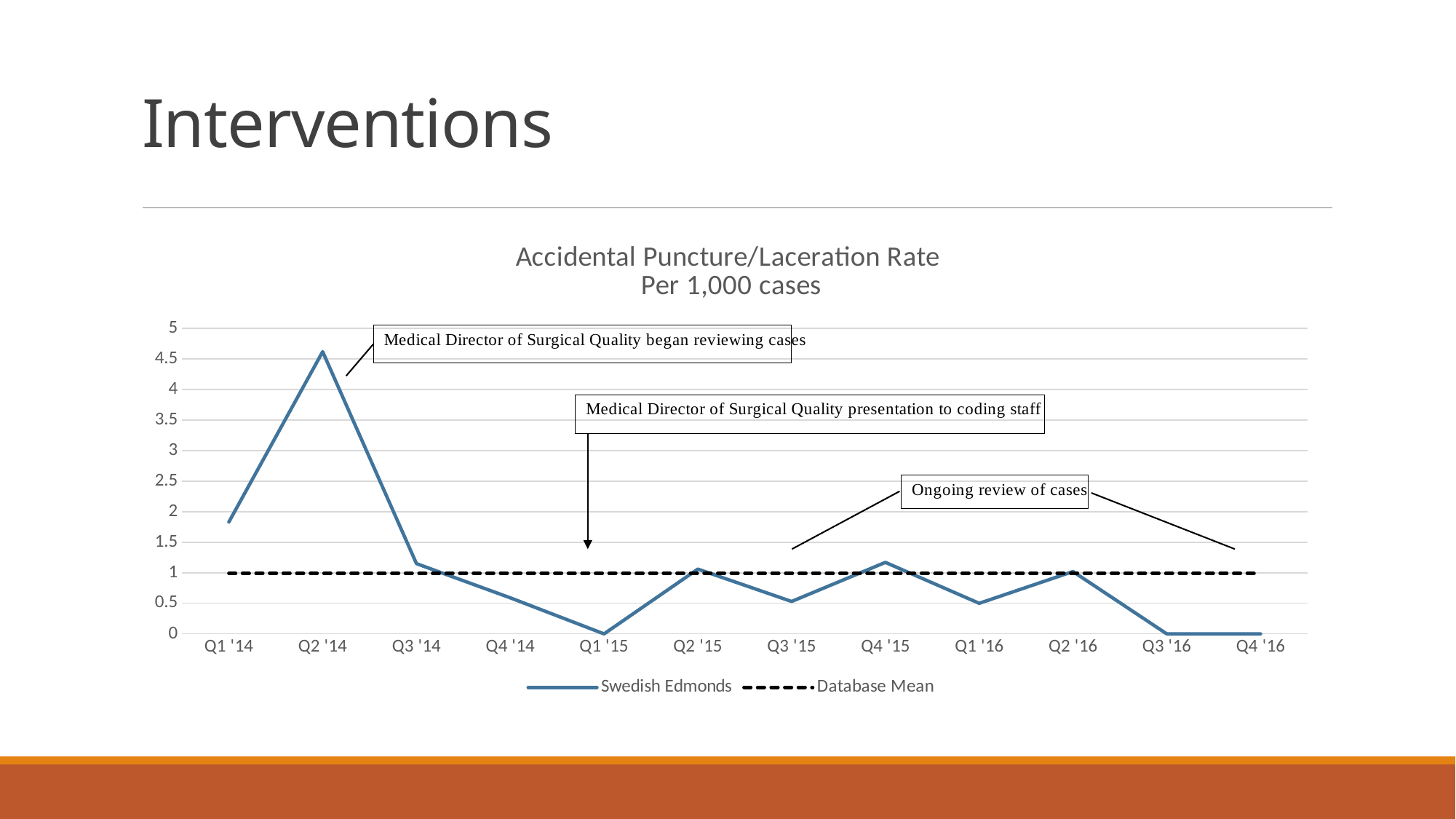
Is the Swedish Edmonds value for Q2 '14 greater or less than 4? greater In which quarter is the Swedish Edmonds rate highest? Q2 '14 Is the Swedish Edmonds value for Q1 '14 greater or less than 1.5? greater What is the Swedish Edmonds value for Q1 '15? 0 What is the title of the chart? Accidental Puncture/Laceration Rate Per 1,000 cases Is the Swedish Edmonds value for Q3 '15 greater or less than 1? less Does the Swedish Edmonds line rise or fall from Q2 '14 to Q1 '15? fall Which is larger, the Swedish Edmonds value for Q2 '14 or for Q3 '14? Q2 '14 How many quarters are plotted along the x axis? 12 How many series does the legend list? 2 What kind of chart is shown on the slide? line chart